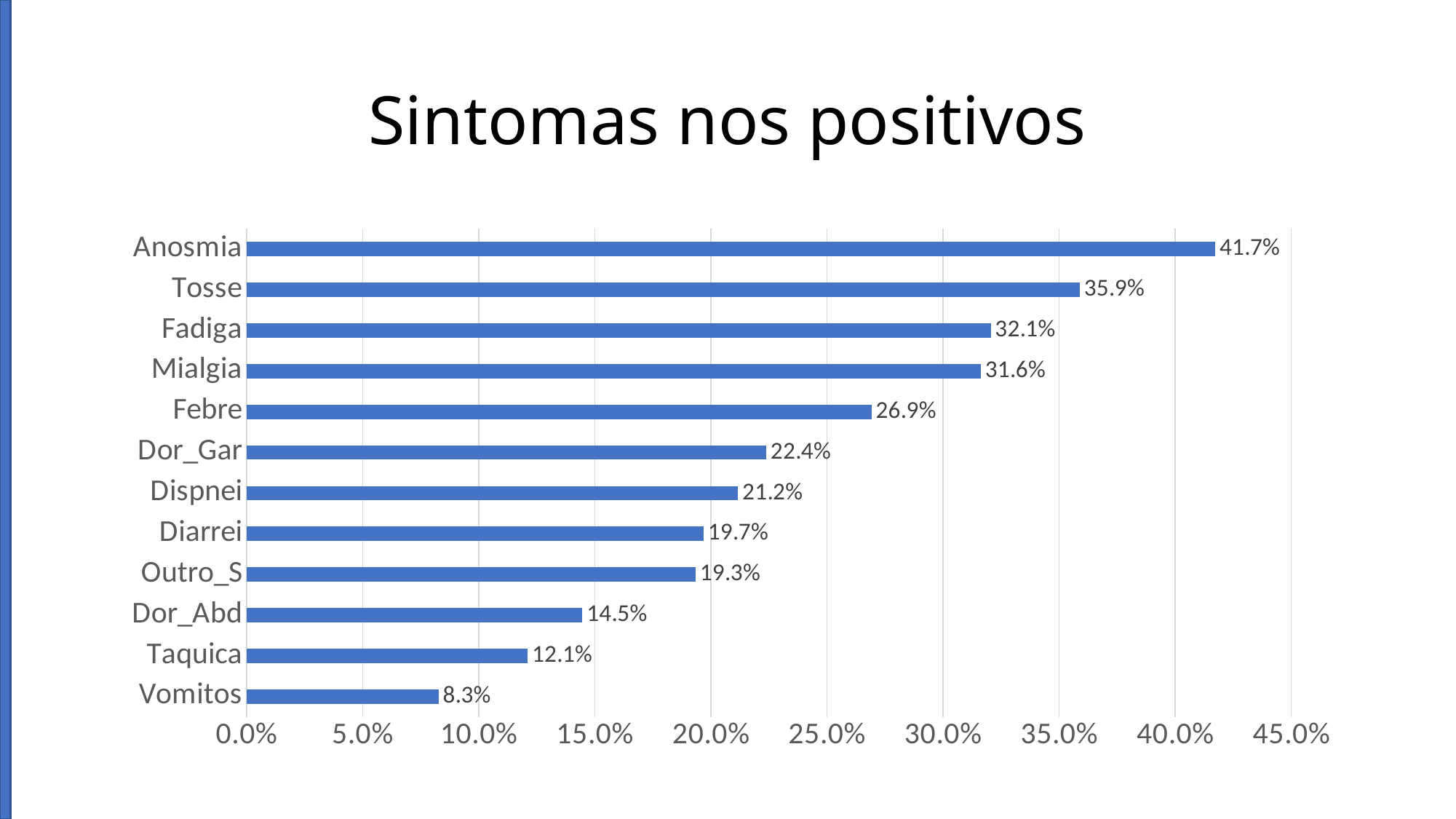
What kind of chart is shown on the slide? Bar chart What is the value for Anosmia? 41.7% What is the value for Taquica? 12.1% Which symptom has the highest value? Anosmia Which symptom has the lowest value? Vomitos Is the value for Mialgia greater or less than 30.0%? greater Which is larger, the value for Dor_Gar or the value for Dispnei? Dor_Gar What is the title of the chart? Sintomas nos positivos What is the difference between the values for Dor_Abd and Vomitos? 6.2% How many symptoms are shown in the chart? 12 What is the value for Febre? 26.9% What is the difference between the values for Tosse and Fadiga? 3.8%